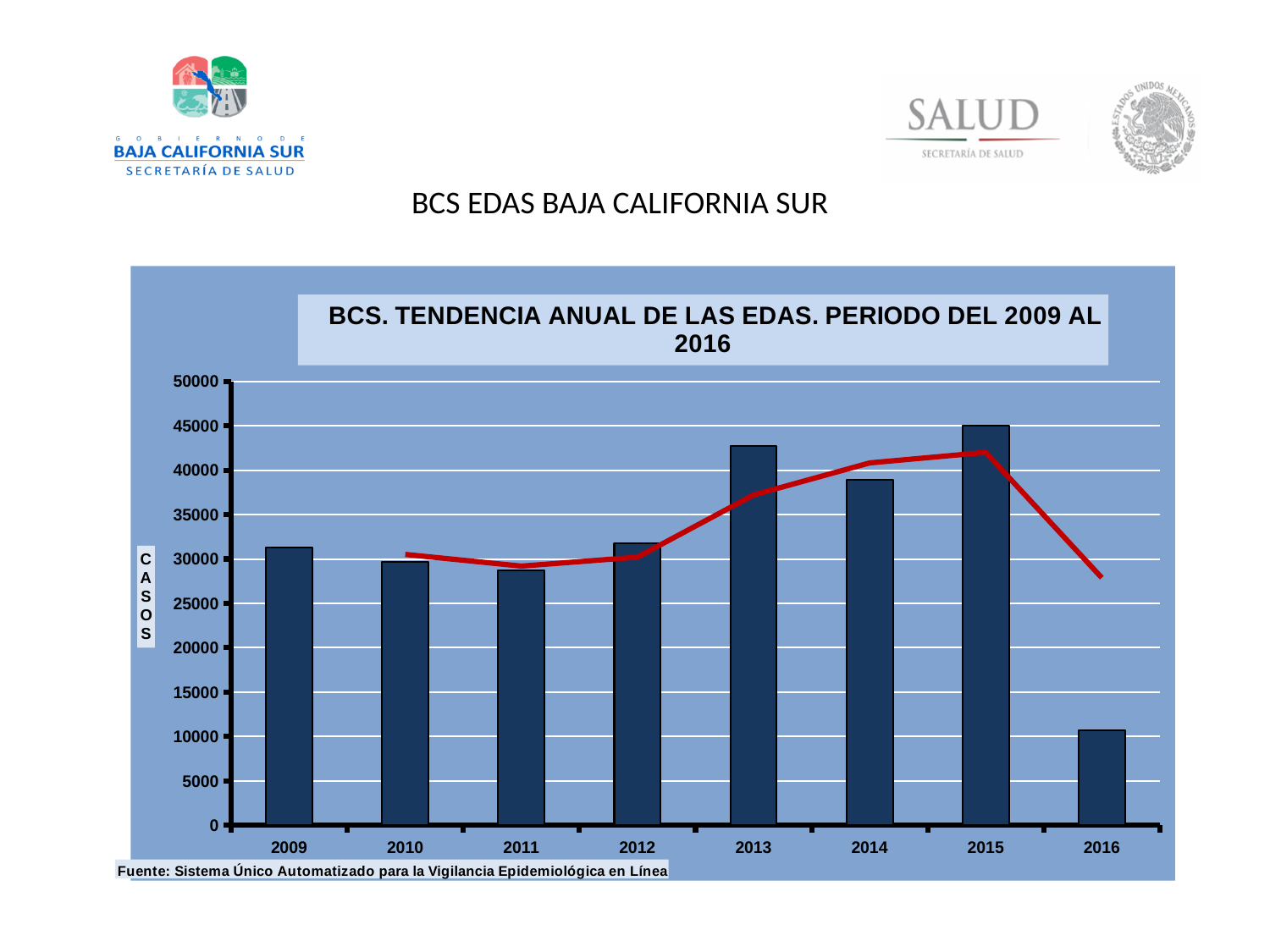
Do the bar values rise or fall from 2015 to 2016? fall Is the value for 2015 greater or less than 40000? greater Which year has the lowest bar in the chart? 2016 Which year has the larger value, 2009 or 2011? 2009 What kind of chart is shown on the slide? bar chart How many years are shown on the x axis of the chart? 8 Which year has the larger value, 2013 or 2014? 2013 Which year has the highest bar in the chart? 2015 Is the value for 2013 greater or less than 40000? greater Is the value for 2016 greater or less than 15000? less What is the title of the chart? BCS. TENDENCIA ANUAL DE LAS EDAS. PERIODO DEL 2009 AL 2016